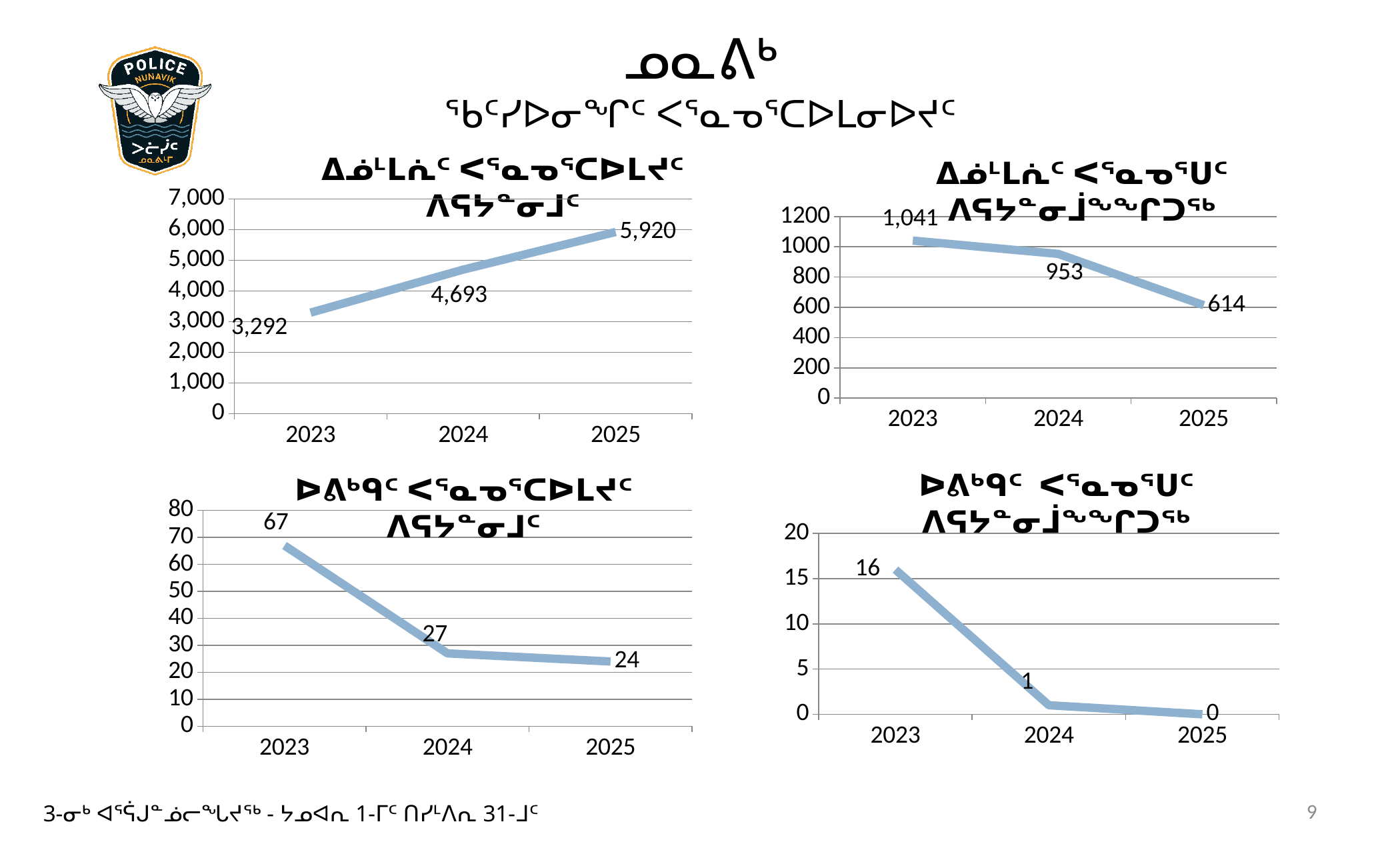
In the top-left chart, what is the value for 2025? 5,920 What type of chart is the bottom-right chart? line chart In the top-left chart, what is the difference between the 2025 and 2023 values? 2,628 In the top-left chart, what is the value for 2023? 3,292 In the bottom-right chart, what is the value for 2025? 0 In the top-left chart, do the values rise or fall from 2023 to 2025? rise In the top-right chart, which year has the lowest value? 2025 In the bottom-left chart, which is larger, the value for 2024 or the value for 2025? 2024 In the top-right chart, what is the difference between the 2023 and 2025 values? 427 In the bottom-right chart, which year has the highest value? 2023 In the top-right chart, what is the value for 2024? 953 In the bottom-left chart, what is the value for 2023? 67